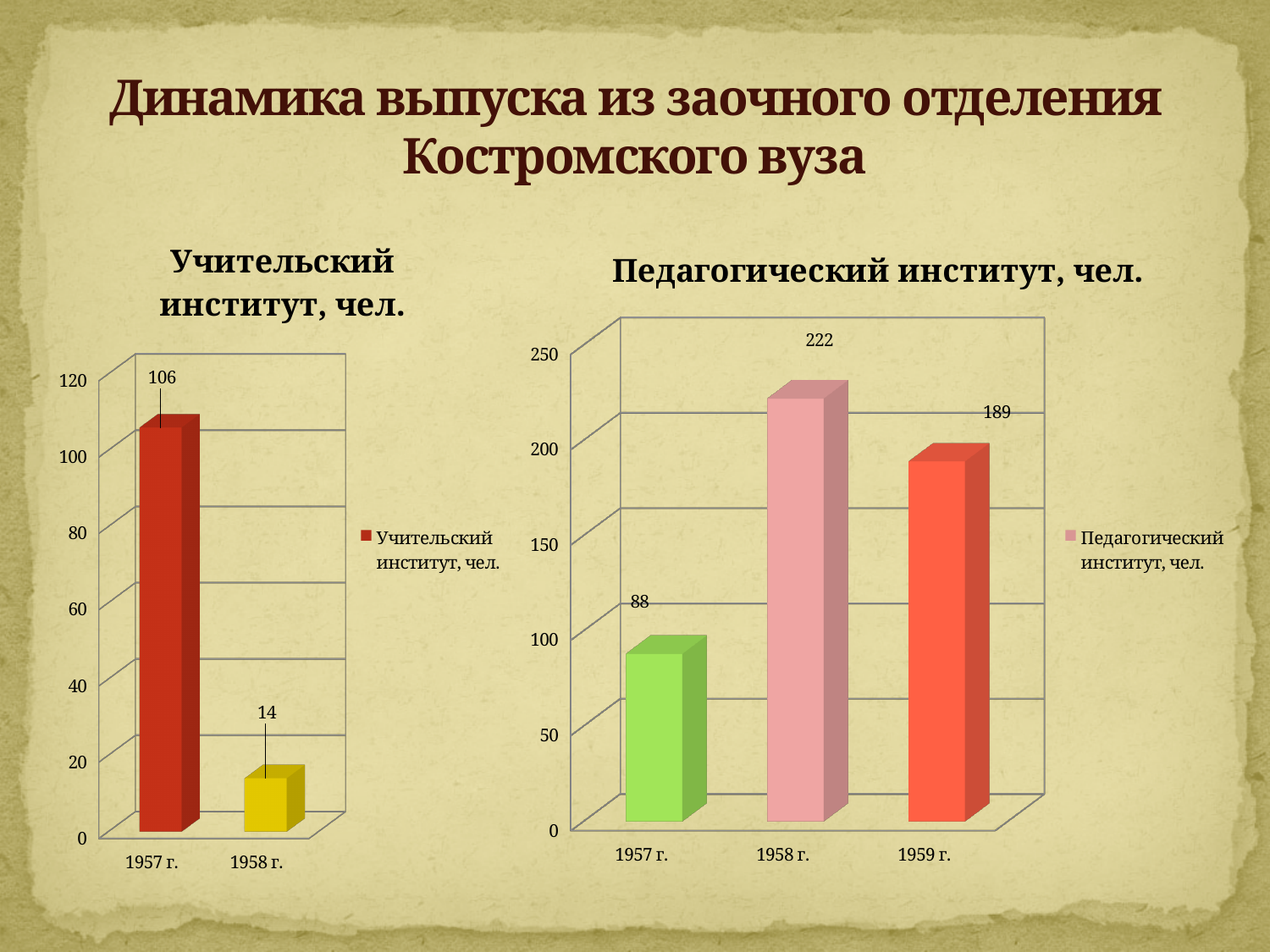
In the chart titled "Учительский институт, чел.", what is the value for 1958 г.? 14 In the chart titled "Педагогический институт, чел.", which year has the lowest value? 1957 г. In the chart titled "Педагогический институт, чел.", what is the value for 1957 г.? 88 How many years are shown in the chart titled "Педагогический институт, чел."? 3 In the chart titled "Учительский институт, чел.", do the values rise or fall from 1957 г. to 1958 г.? Fall In the chart titled "Педагогический институт, чел.", what is the difference between the values for 1958 г. and 1959 г.? 33 What type of chart is the chart titled "Учительский институт, чел."? Bar chart In the chart titled "Учительский институт, чел.", what is the difference between the values for 1957 г. and 1958 г.? 92 In the chart titled "Педагогический институт, чел.", what is the value for 1958 г.? 222 In the chart titled "Учительский институт, чел.", what is the value for 1957 г.? 106 In the chart titled "Педагогический институт, чел.", which year has the highest value? 1958 г. In the chart titled "Педагогический институт, чел.", which is larger: the value for 1959 г. or the value for 1957 г.? 1959 г.